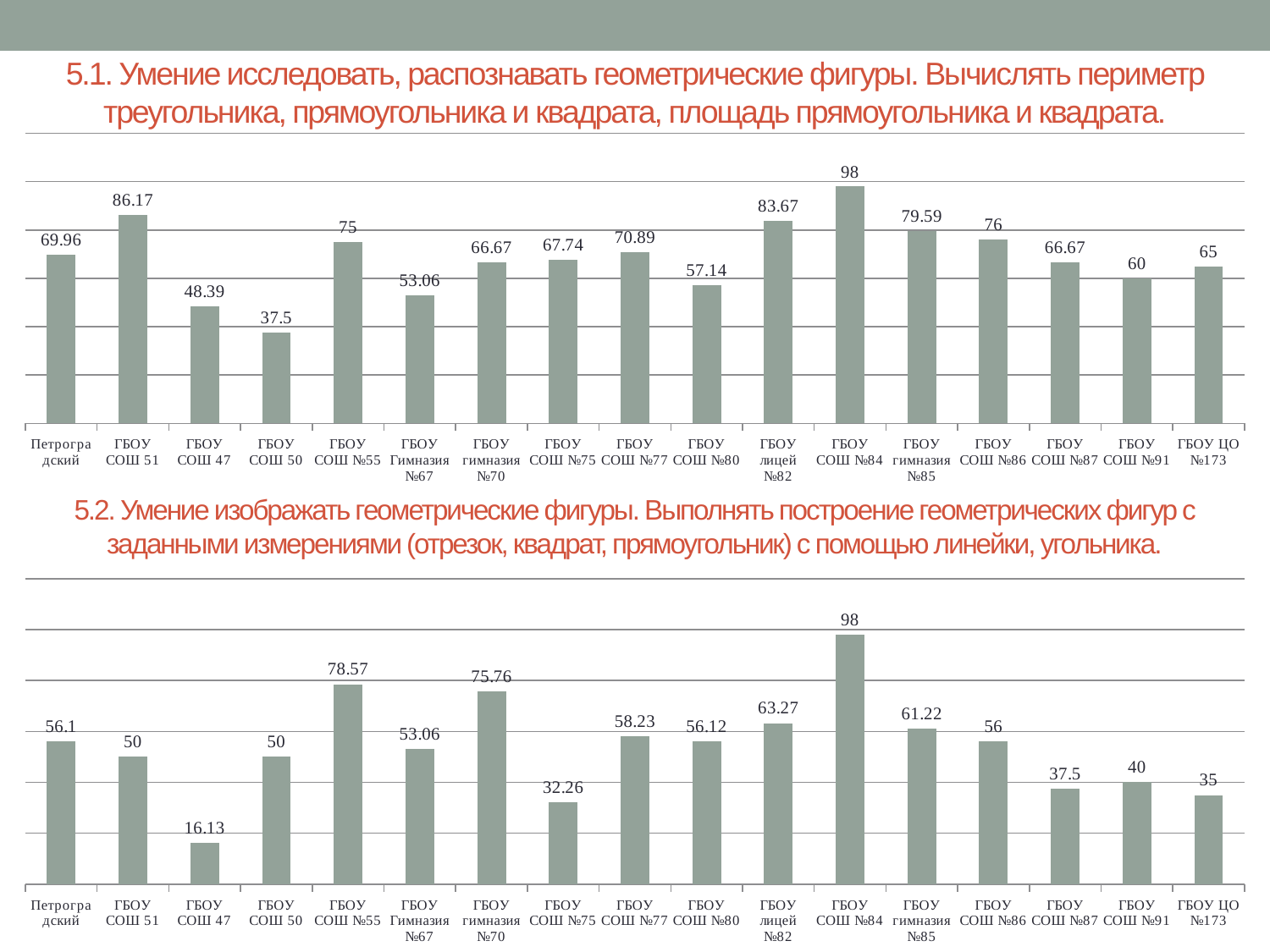
In the bottom chart (5.2), what is the value for ГБОУ ЦО №173? 35 What type of chart is used in the top chart (5.1)? Bar chart In the bottom chart (5.2), what is the difference between ГБОУ СОШ №84 and ГБОУ СОШ №75? 65.74 In the top chart (5.1), which school has the highest value? ГБОУ СОШ №84 In the top chart (5.1), what is the difference between ГБОУ лицей №82 and ГБОУ СОШ №80? 26.53 In the top chart (5.1), which school has the lowest value? ГБОУ СОШ 50 In the top chart (5.1), how many schools (categories) are shown? 17 In the top chart (5.1), what is the value for ГБОУ СОШ 51? 86.17 In the top chart (5.1), what is the value for Петроградский? 69.96 In the bottom chart (5.2), what is the value for ГБОУ СОШ 47? 16.13 In the bottom chart (5.2), which is larger: ГБОУ СОШ №55 or ГБОУ гимназия №70? ГБОУ СОШ №55 In the bottom chart (5.2), which school has the lowest value? ГБОУ СОШ 47